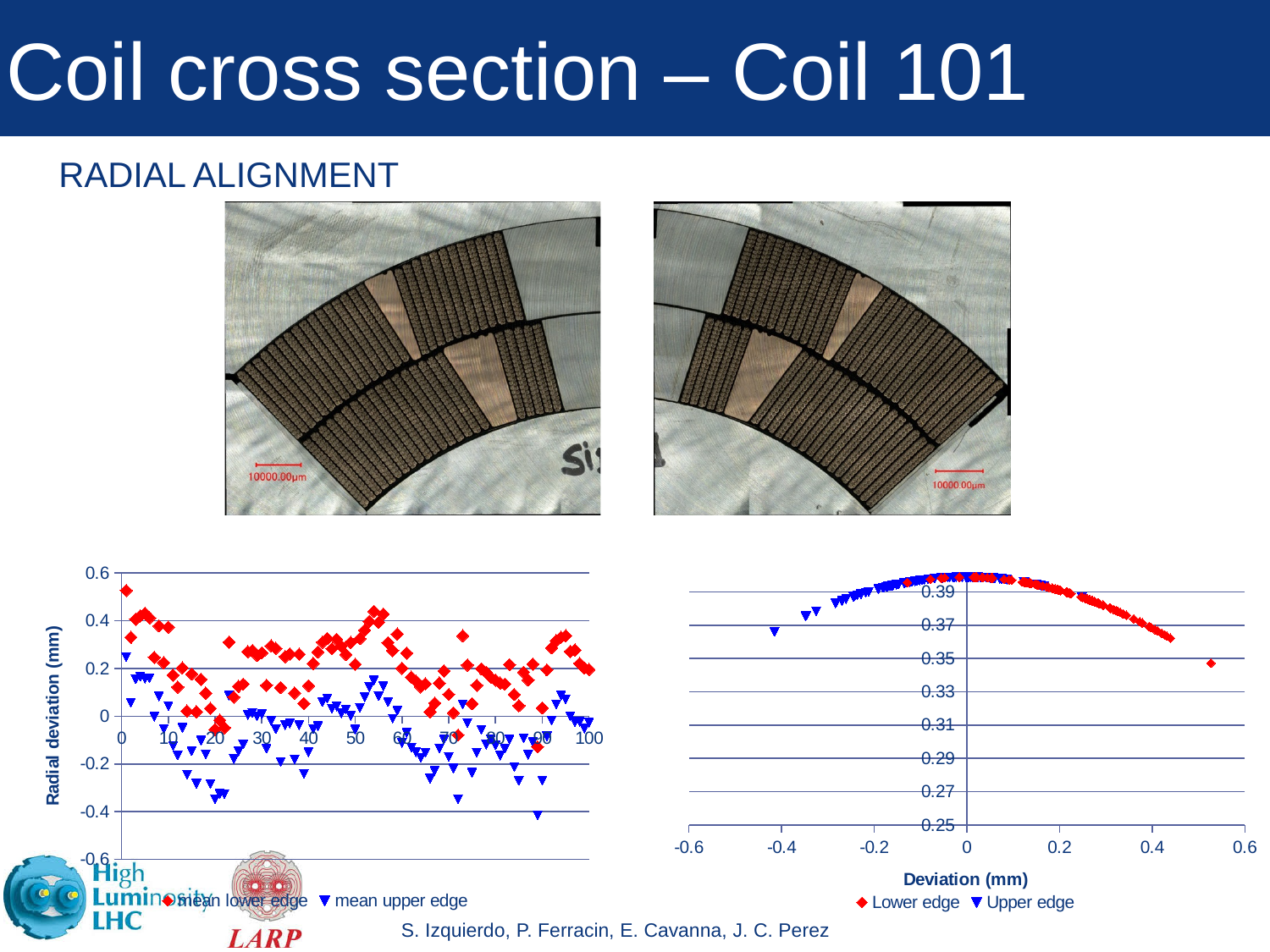
What is the x-axis title of the bottom-right chart? Deviation (mm) In the bottom-left chart, is the lowest 'mean upper edge' value greater or less than -0.2? less How many series does the legend of the bottom-right chart list? 2 What kind of chart is the bottom-left chart with the y-axis 'Radial deviation (mm)'? scatter chart In the bottom-right chart, is the peak value of the plotted points greater or less than 0.37? greater What kind of chart is the bottom-right chart with the x-axis 'Deviation (mm)'? scatter chart In the bottom-left chart, which series generally has the higher radial deviation values, 'mean lower edge' or 'mean upper edge'? mean lower edge How many series does the legend of the bottom-left chart list? 2 What are the two series named in the legend of the bottom-left chart? mean lower edge, mean upper edge In the bottom-right chart, which series has the point at the largest positive deviation, 'Lower edge' or 'Upper edge'? Lower edge In the bottom-left chart, is the highest 'mean lower edge' value greater or less than 0.4? greater In the bottom-right chart, do the values rise or fall as the deviation increases from 0 to 0.4? fall